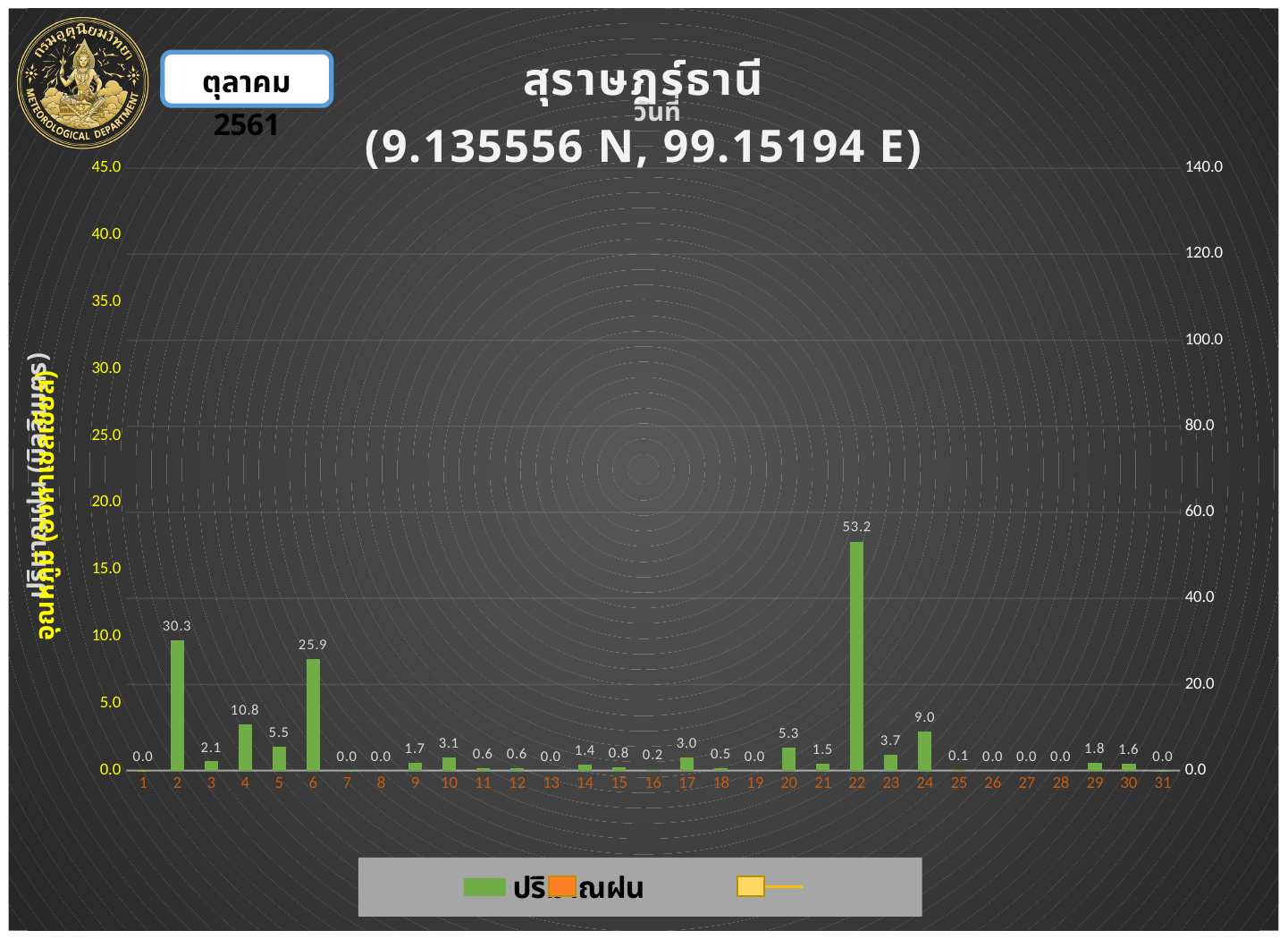
Is the rainfall value for day 22 greater or less than 40.0 on the right-hand axis? greater Which has the larger rainfall value, day 4 or day 5? day 4 How many entries does the legend list? 3 What is the rainfall value shown for day 22? 53.2 What is the rainfall value shown for day 24? 9.0 How many days are shown along the x axis? 31 What kind of chart is shown on the slide? bar chart What is the difference between the rainfall values for day 22 and day 2? 22.9 What is the rainfall value shown for day 2? 30.3 What station name is shown in the chart title? สุราษฎร์ธานี Which day has the highest rainfall value? 22 What is the rainfall value shown for day 6? 25.9